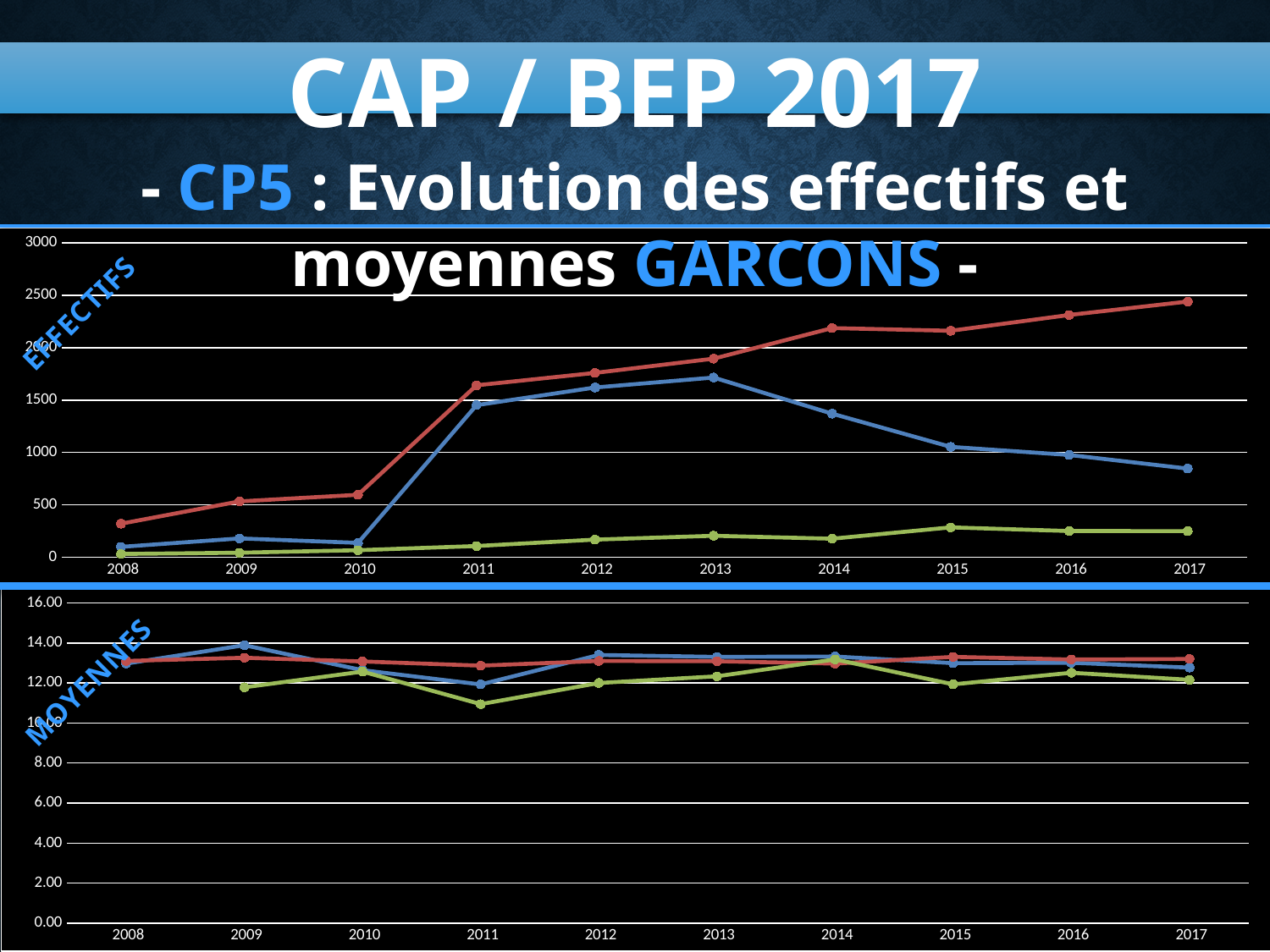
In the top chart (EFFECTIFS), how many years are shown on the x axis? 10 In the top chart (EFFECTIFS), in which year does the blue line reach its highest value? 2013 In the top chart (EFFECTIFS), how many lines are plotted? 3 In the top chart (EFFECTIFS), is the value of the red line in 2017 greater or less than 2000? greater In the top chart (EFFECTIFS), is the value of the red line in 2008 greater or less than 500? less What kind of chart is the top chart labelled EFFECTIFS? line chart In the top chart (EFFECTIFS), is the value of the blue line in 2017 greater or less than 1000? less What is the label written along the y axis of the bottom chart? MOYENNES In the top chart (EFFECTIFS), does the red line generally rise or fall from 2008 to 2017? rise In the top chart (EFFECTIFS), in which year does the red line reach its highest value? 2017 In the top chart (EFFECTIFS), which line has the larger value in 2017, the red line or the blue line? the red line